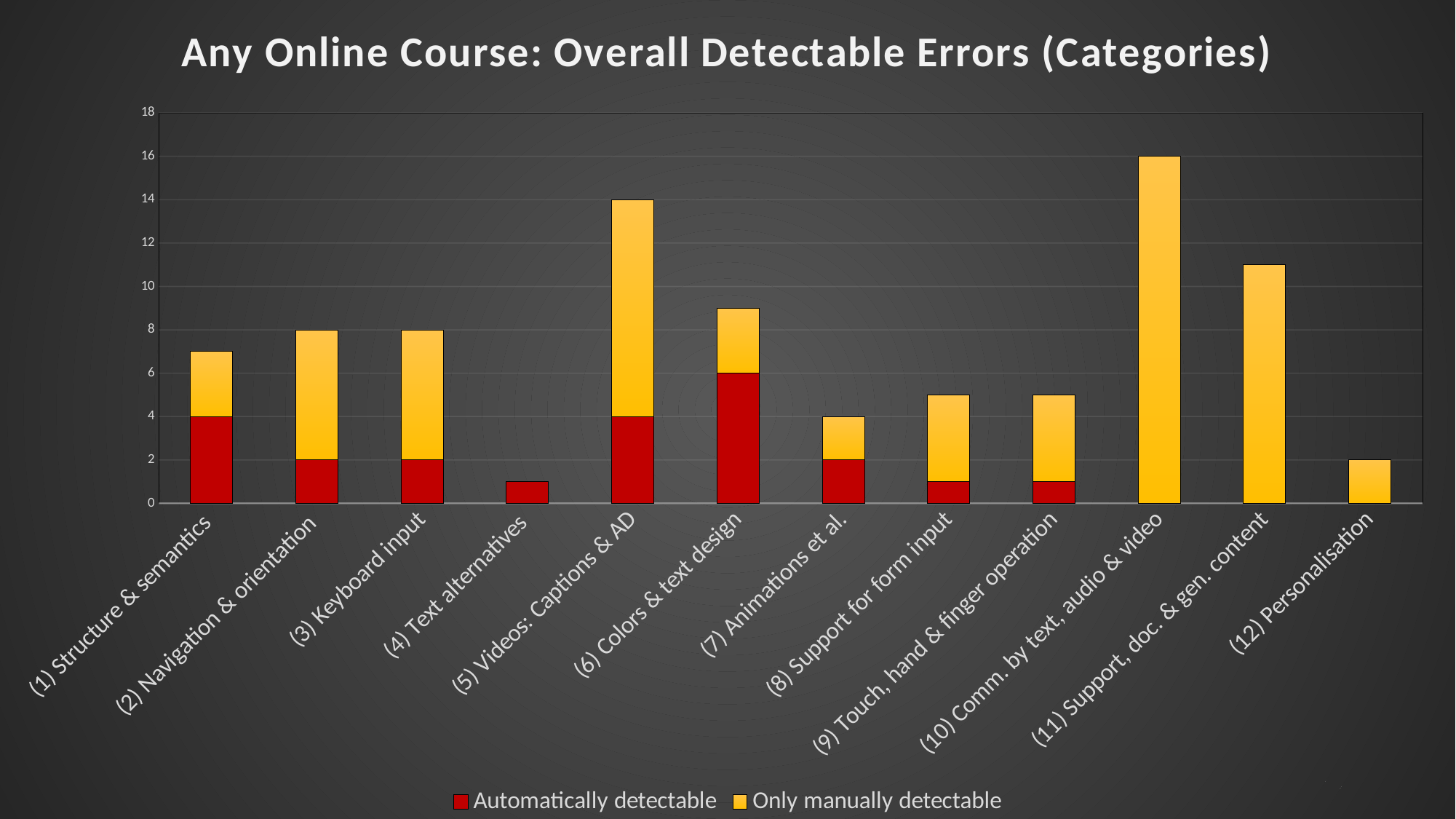
What is the Automatically detectable value for (1) Structure & semantics? 4 How many series does the legend list? 2 What type of chart is shown on the slide? Stacked bar chart How many categories are shown on the x axis? 12 Is the total value for (6) Colors & text design greater or less than 8? greater What is the total value of the bar for (5) Videos: Captions & AD? 14 What is the total value of the bar for (10) Comm. by text, audio & video? 16 Which colour represents the 'Only manually detectable' series? Yellow Which category has the highest total bar? (10) Comm. by text, audio & video What is the difference between the total bars for (10) Comm. by text, audio & video and (5) Videos: Captions & AD? 2 Is the total value for (11) Support, doc. & gen. content greater or less than 12? less Which has a larger total bar, (5) Videos: Captions & AD or (6) Colors & text design? (5) Videos: Captions & AD